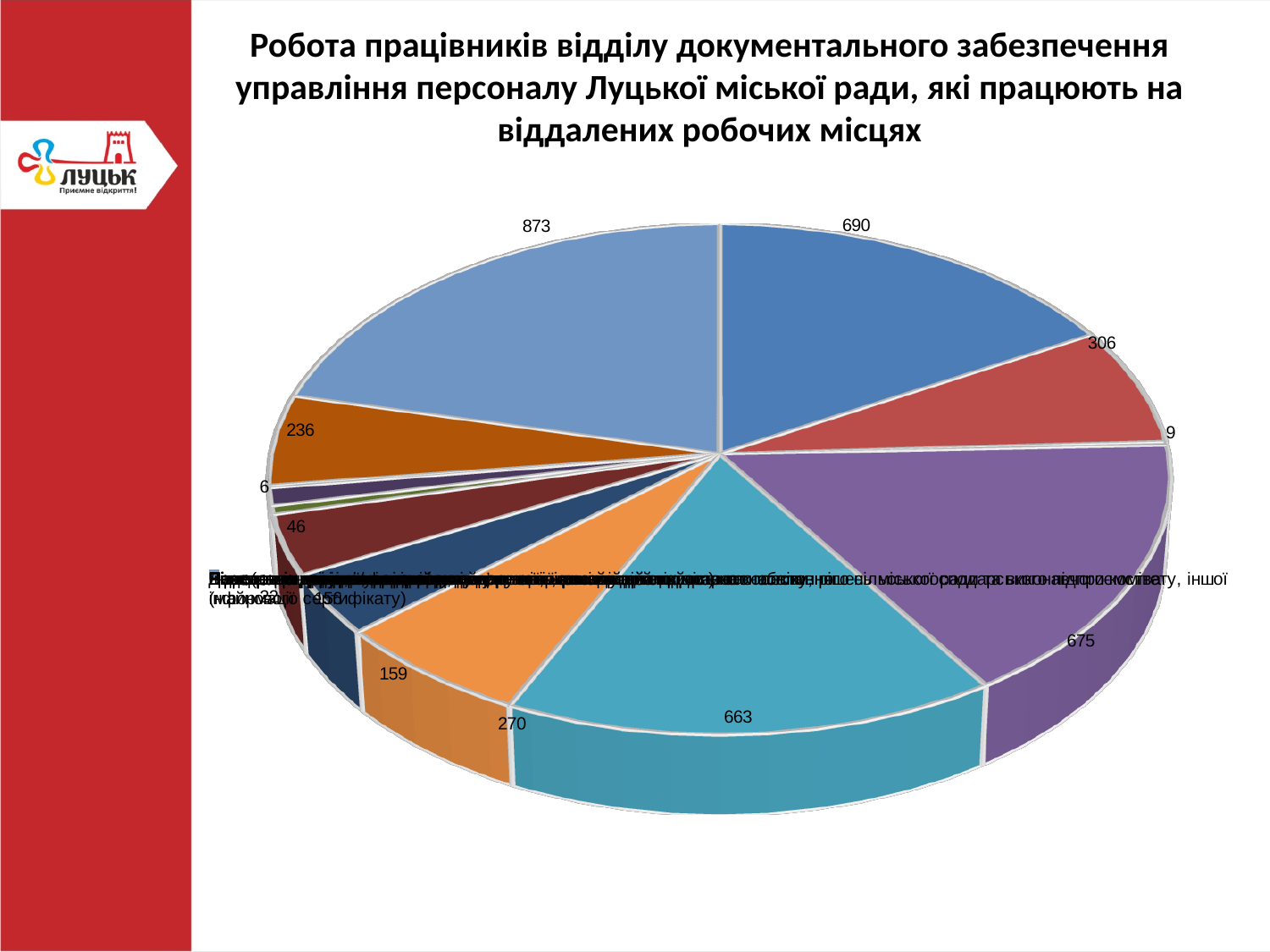
What is the difference between the slice labelled 690 and the slice labelled 306? 384 What is the first word of the chart title on the slide? Робота What colour is the largest slice of the pie chart (labelled 873)? light blue What value is labelled on the purple slice on the right side of the pie chart? 675 What value is labelled on the orange slice at the bottom left of the pie chart? 270 Which is larger, the slice labelled 675 or the slice labelled 663? 675 What is the difference between the slice labelled 873 and the slice labelled 690? 183 What value is labelled on the dark blue slice at the top right of the pie chart? 690 Which is larger, the slice labelled 270 or the slice labelled 159? 270 What kind of chart is shown on the slide? pie chart What is the largest value labelled on the pie chart? 873 What value is labelled on the teal slice at the bottom of the pie chart? 663